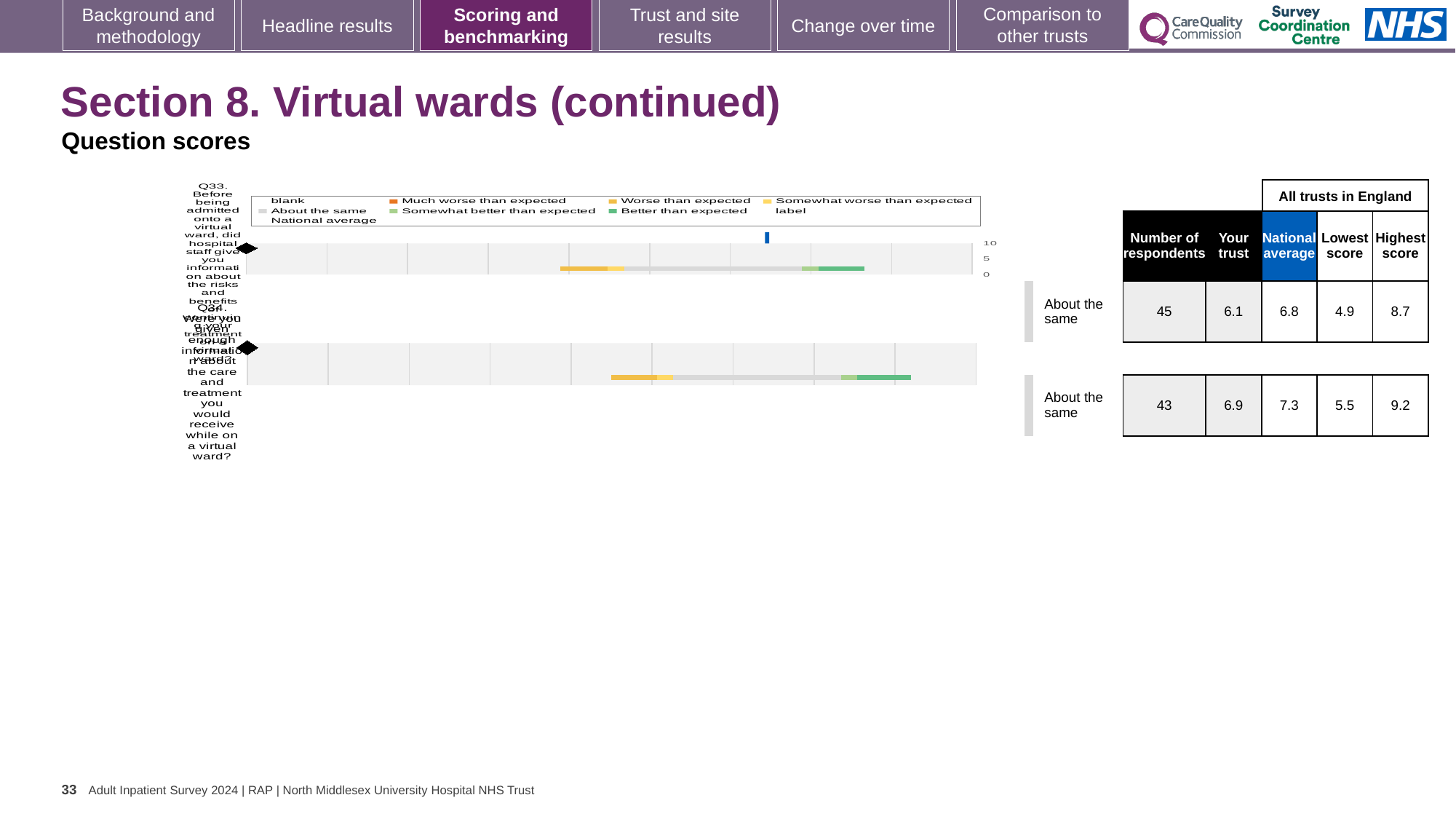
Is the 'Your trust' score for Q34 greater or less than 5? greater What is the highest score among all trusts in England for Q34? 9.2 What is the national average score for Q34? 7.3 How many respondents answered Q33? 45 How many questions are plotted in the chart? 2 Which colour in the legend represents 'Better than expected'? Green What is the 'Your trust' score for Q33? 6.1 What is the difference between the highest and lowest scores for Q34? 3.7 For Q33, which is larger: the 'Your trust' score or the national average? National average What kind of chart is used to show the question scores for Q33 and Q34? bar chart What is the lowest score among all trusts in England for Q33? 4.9 Which benchmark category is Q33 placed in? About the same